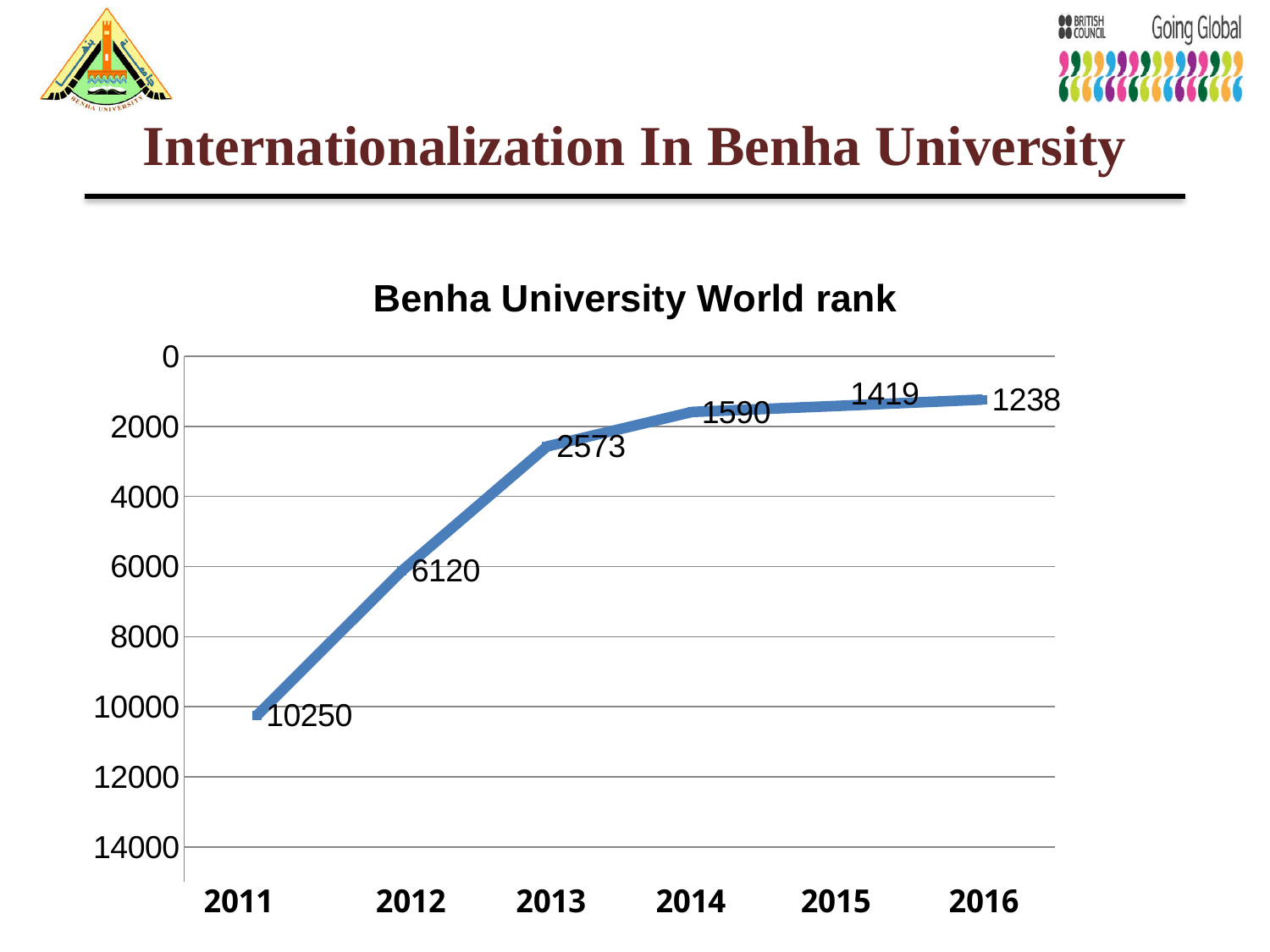
How many years are plotted on the chart? 6 Which year has the larger numeric world rank value, 2012 or 2014? 2012 What is the Benha University world rank shown for 2016? 1238 Which year has the highest numeric world rank value on the chart? 2011 What is the difference between the world rank values for 2011 and 2012? 4130 Which year has the lowest numeric world rank value on the chart? 2016 Do the numeric world rank values rise or fall from 2011 to 2016? Fall What is the Benha University world rank shown for 2011? 10250 What is the Benha University world rank shown for 2015? 1419 What kind of chart is shown on the slide? Line chart What is the Benha University world rank shown for 2013? 2573 What is the difference between the world rank values for 2013 and 2014? 983